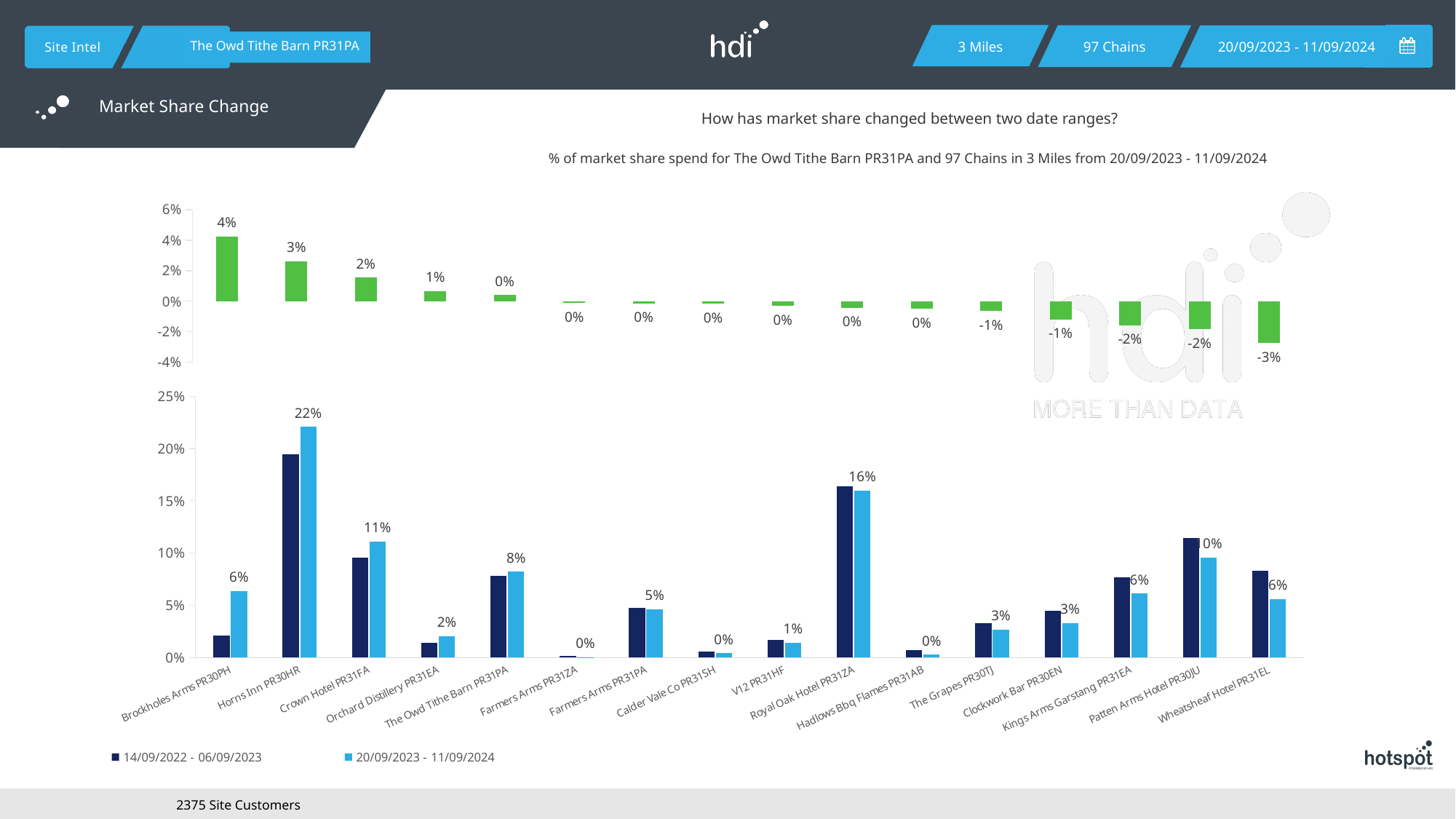
In the bottom chart, is the value for Horns Inn PR30HR in the 14/09/2022 - 06/09/2023 series greater or less than 15%? greater In the bottom chart, what is the value for Royal Oak Hotel PR31ZA in the 20/09/2023 - 11/09/2024 series? 16% In the bottom chart, which category has the highest value in the 20/09/2023 - 11/09/2024 series? Horns Inn PR30HR In the top chart, what is the difference between the market share change for Horns Inn PR30HR and Crown Hotel PR31FA? 1% In the top chart, what is the market share change for Brockholes Arms PR30PH? 4% In the top chart, what is the market share change for Wheatsheaf Hotel PR31EL? -3% In the top chart, which category has the lowest market share change? Wheatsheaf Hotel PR31EL How many series does the legend of the bottom chart list? 2 In the bottom chart, what is the value for Horns Inn PR30HR in the 20/09/2023 - 11/09/2024 series? 22% How many categories are shown on the x axis of the bottom chart? 16 In the top chart, which category has the highest market share change? Brockholes Arms PR30PH